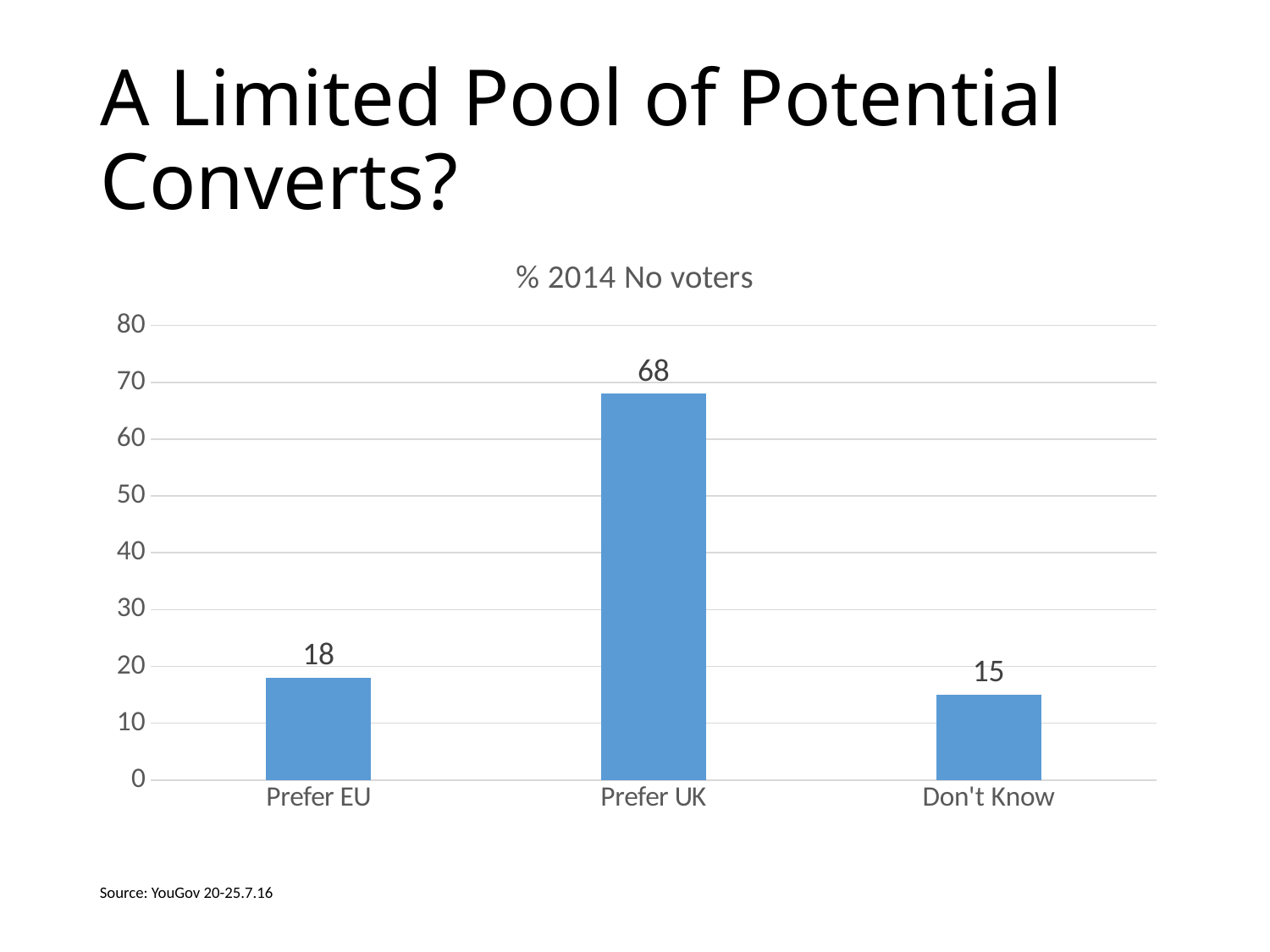
What is the title of the chart? % 2014 No voters Which category has the highest value? Prefer UK Is the value for Prefer UK greater or less than 60? greater What is the difference between the values for Prefer UK and Prefer EU? 50 Which category has the lowest value? Don't Know What is the difference between the values for Prefer EU and Don't Know? 3 How many categories are shown on the x axis? 3 Which is larger, the value for Prefer EU or the value for Prefer UK? Prefer UK What is the value for Prefer EU? 18 What is the value for Prefer UK? 68 What kind of chart is shown on the slide? bar chart What is the value for Don't Know? 15